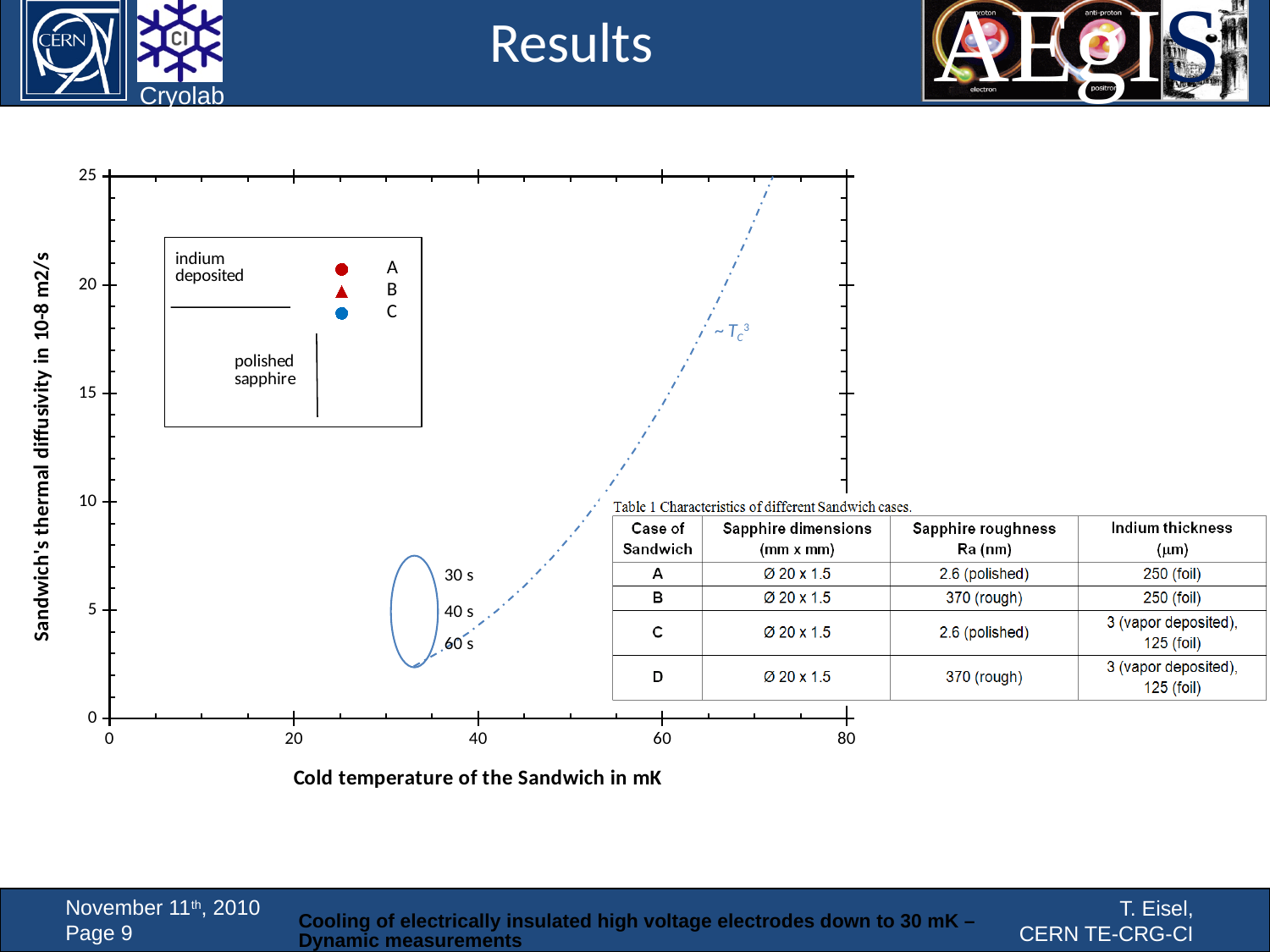
Which time labels are written next to the ellipse on the chart? 30 s, 40 s, 60 s What is the title of the x axis of the chart? Cold temperature of the Sandwich in mK What is the highest value shown on the x axis of the chart? 80 What are the series labels in the chart's legend? A, B, C How many series does the chart's legend list? 3 Is the dashed ~Tc^3 curve at a cold temperature of 60 mK greater or less than 5 on the y axis? greater Does the dashed curve labelled ~Tc^3 rise or fall as the cold temperature increases along the x axis? rise How many time labels (in seconds) are written next to the ellipse on the chart? 3 What kind of chart is shown on the slide? scatter chart What is the highest value shown on the y axis of the chart? 25 Is the dashed ~Tc^3 curve at a cold temperature of 40 mK greater or less than 10 on the y axis? less